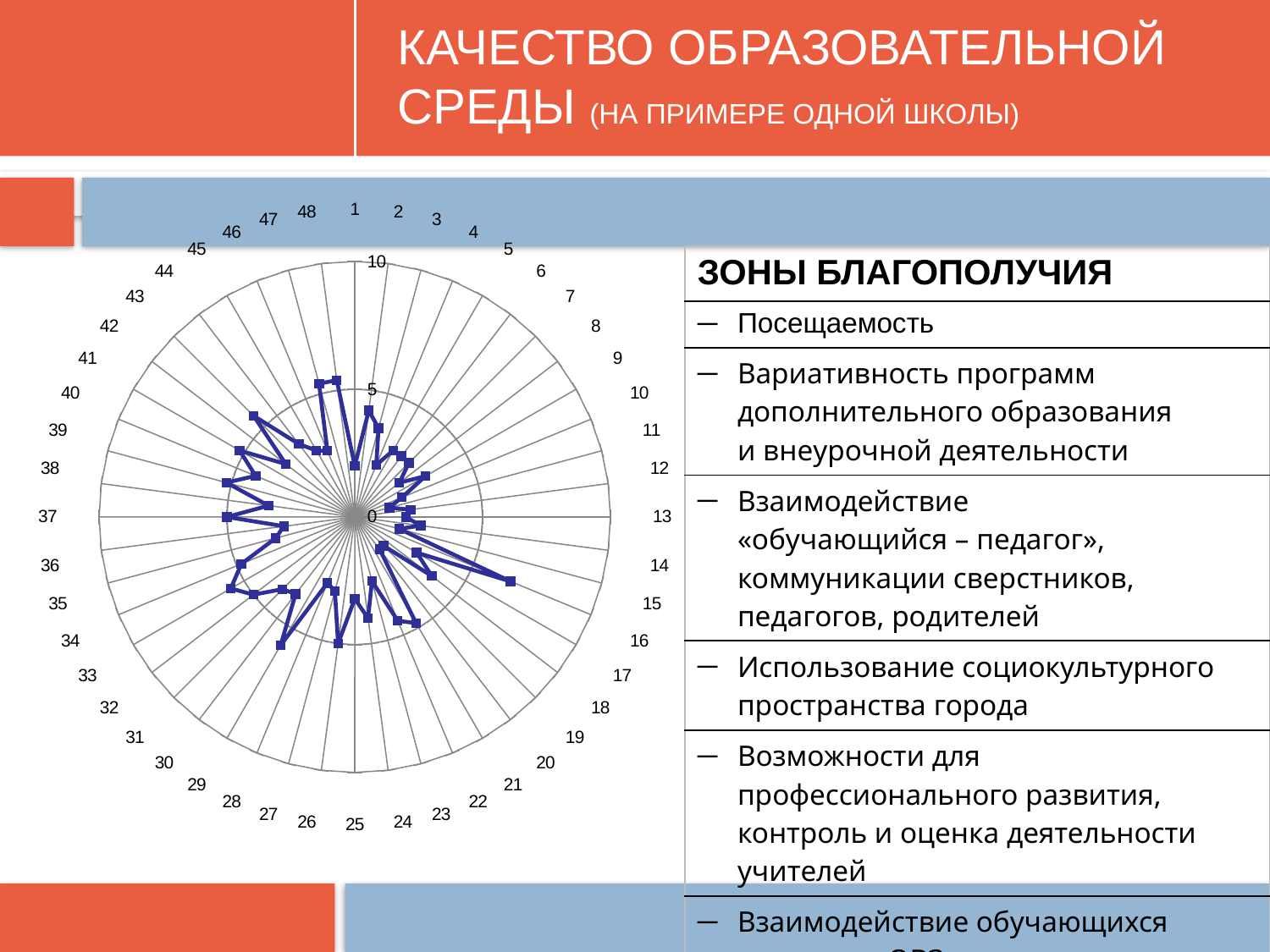
Is the value for category 16 greater or less than 10? less Which is larger, the value for category 16 or the value for category 13? category 16 Is the value for category 16 greater or less than 5? greater What is the maximum value shown on the radial axis of the chart? 10 How many categories are plotted around the radar chart? 48 What is the title of the slide containing the chart? КАЧЕСТВО ОБРАЗОВАТЕЛЬНОЙ СРЕДЫ (НА ПРИМЕРЕ ОДНОЙ ШКОЛЫ) Which category has the highest value on the radar chart? 16 What kind of chart is shown on the slide? radar chart Is the value for category 13 greater or less than 5? less